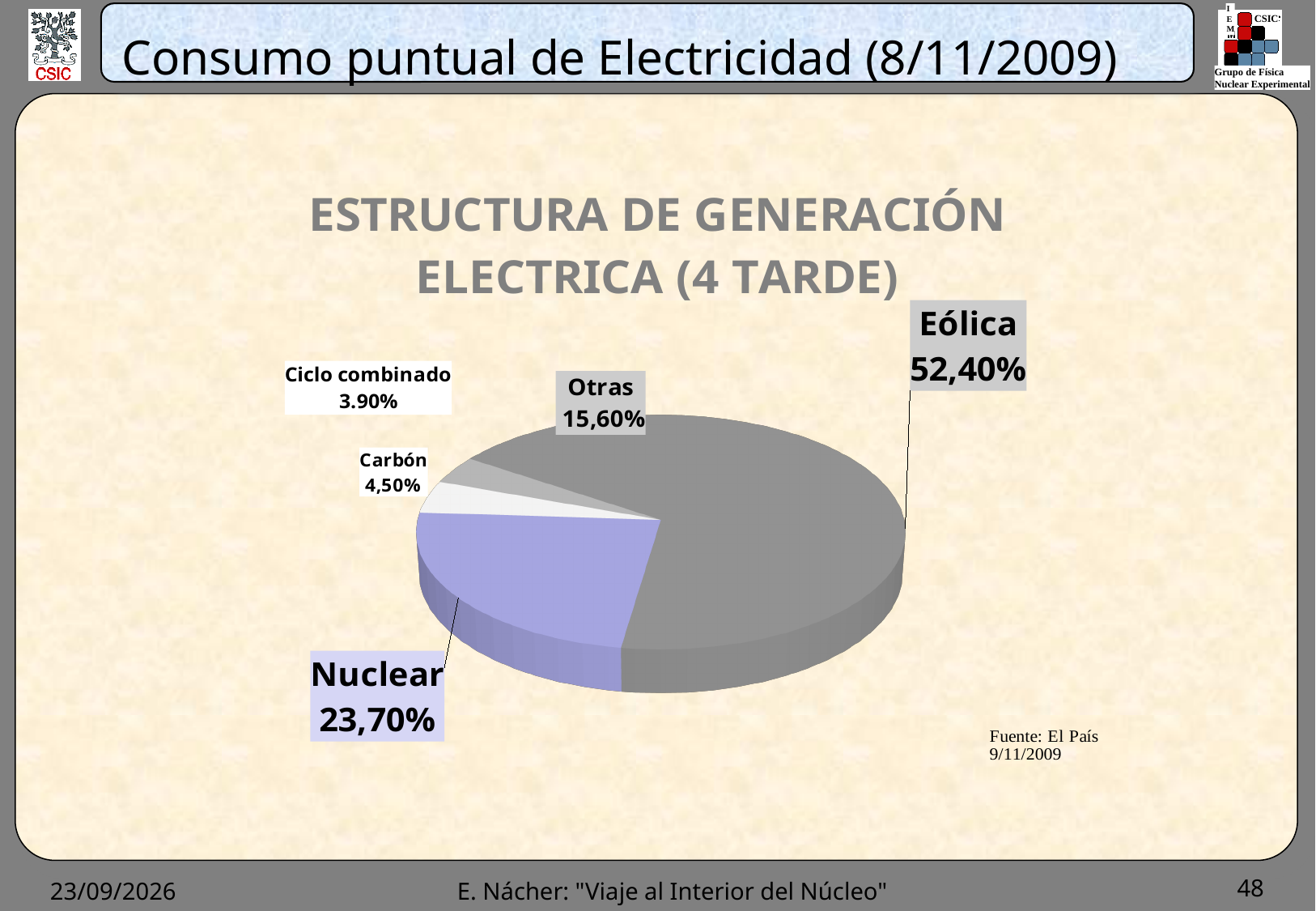
What is the share of Otras in the pie chart? 15,60% What is the title of the pie chart? ESTRUCTURA DE GENERACIÓN ELECTRICA (4 TARDE) What is the difference between the shares of Eólica and Nuclear? 28,70% Which category has the smallest share of the pie? Ciclo combinado What is the share of Nuclear in the pie chart? 23,70% What is the share of Eólica in the pie chart? 52,40% What type of chart is shown on the slide? Pie chart What is the share of Ciclo combinado in the pie chart? 3.90% How many categories are shown in the pie chart? 5 Which category has the largest share of the pie? Eólica What is the share of Carbón in the pie chart? 4,50% Which is larger, the share of Nuclear or the share of Otras? Nuclear